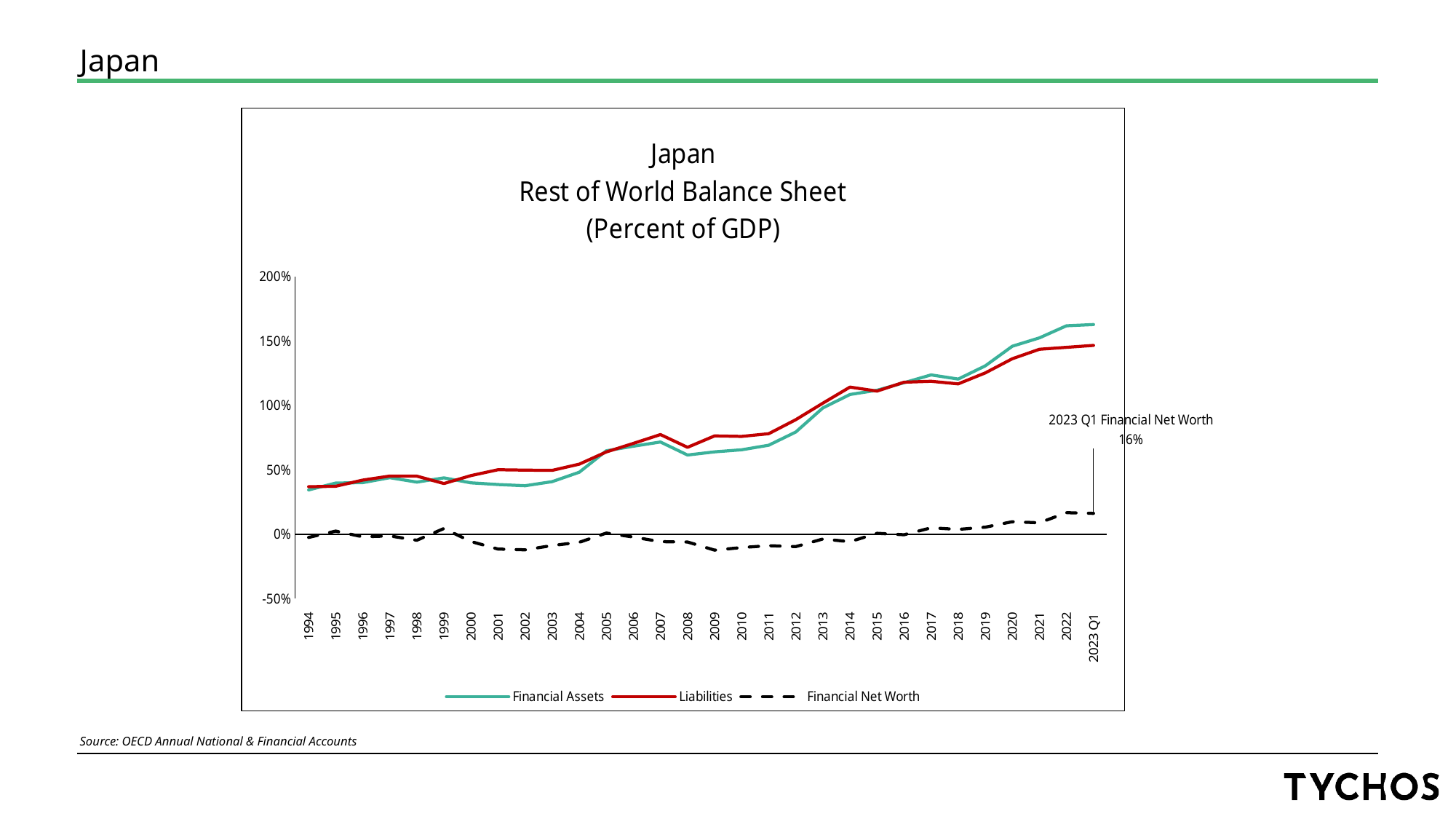
In 2008, which is larger: Financial Assets or Liabilities? Liabilities Is the Financial Assets value for 2023 Q1 greater or less than 150%? greater Is the Liabilities value for 2014 greater or less than 100%? greater Is the Liabilities value for 1994 greater or less than 50%? less What is the Financial Net Worth value for 2023 Q1? 16% What kind of chart is shown on the slide? line chart Which series has the lowest values across the whole period? Financial Net Worth In 2023 Q1, which is larger: Financial Assets or Liabilities? Financial Assets Does the Financial Assets series generally rise or fall from 1994 to 2023 Q1? rise How many series does the legend list? 3 Which series is drawn as a dashed line? Financial Net Worth How many time points are shown on the x axis? 30